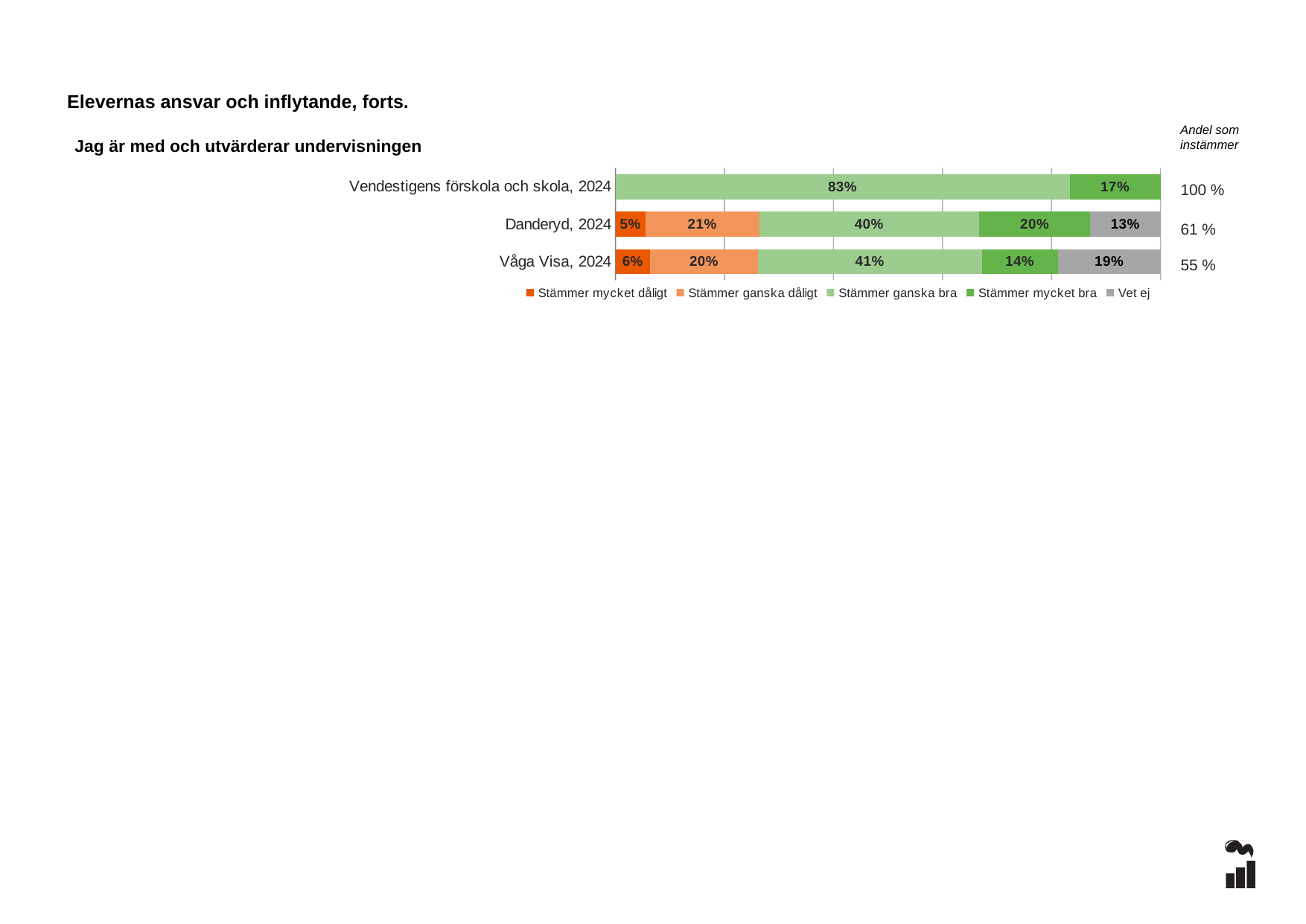
Which is larger: the "Vet ej" value for Danderyd, 2024 or for Våga Visa, 2024? Våga Visa, 2024 What is the "Andel som instämmer" value shown for Danderyd, 2024? 61 % What is the value of "Stämmer mycket bra" for Danderyd, 2024? 20% What kind of chart is shown on the slide? Stacked bar chart How many series does the legend list? 5 How many categories (bars) are shown in the chart? 3 What is the value of "Stämmer ganska dåligt" for Danderyd, 2024? 21% What is the value of "Vet ej" for Våga Visa, 2024? 19% What is the difference between the "Stämmer mycket bra" values for Danderyd, 2024 and Våga Visa, 2024? 6% Which category has the highest value for "Stämmer ganska bra"? Vendestigens förskola och skola, 2024 What is the value of "Stämmer ganska bra" for Vendestigens förskola och skola, 2024? 83% Which category has the lowest value for "Stämmer mycket bra"? Våga Visa, 2024